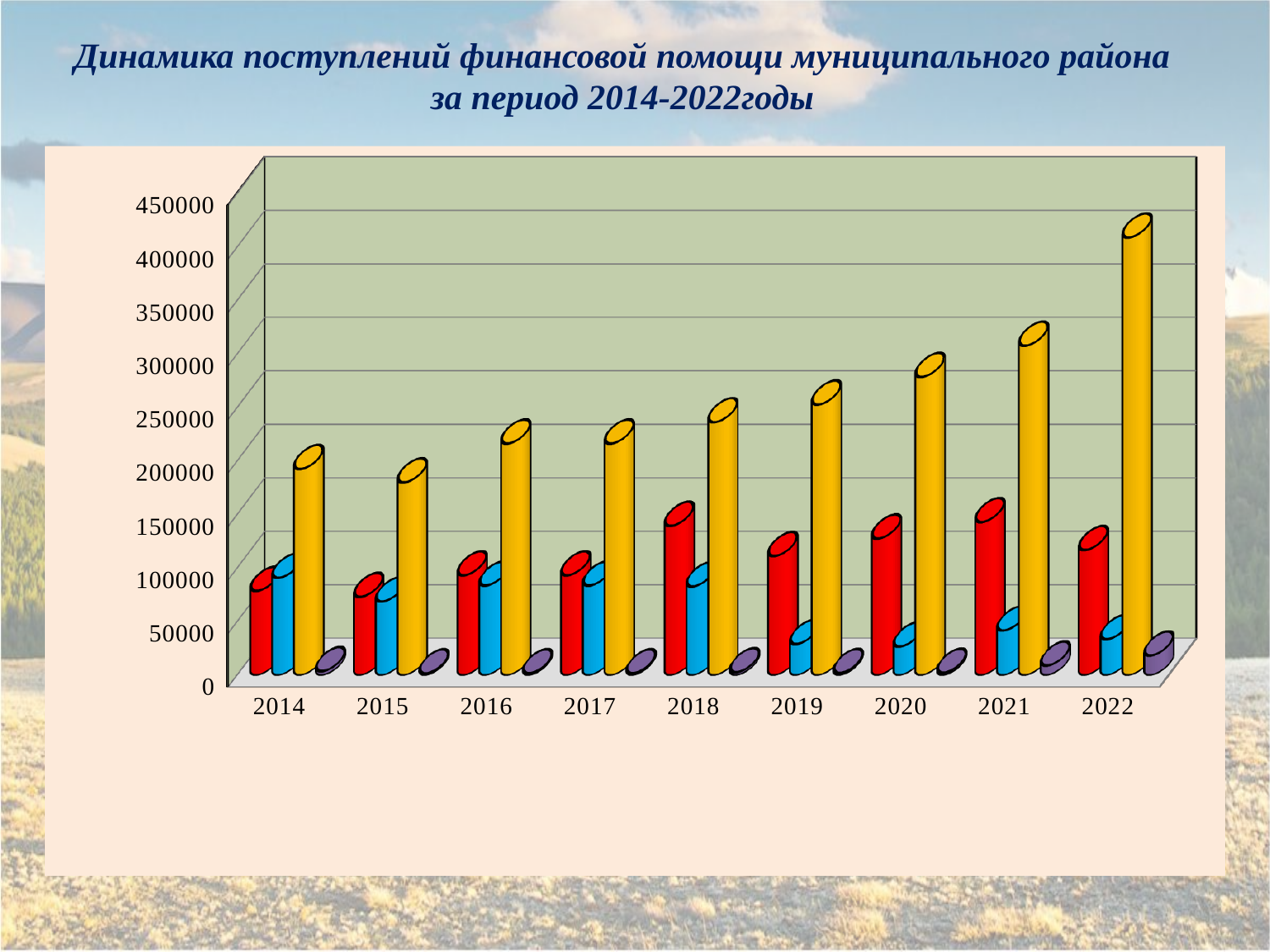
What is the title of the chart on the slide? Динамика поступлений финансовой помощи муниципального района за период 2014-2022годы Is the value of the yellow bar for 2022 greater or less than 400000? greater What kind of chart is shown on the slide? bar chart Is the value of the purple bar for 2018 greater or less than 50000? less In which year is the yellow bar the tallest? 2022 How many bars are plotted for each year in the chart? 4 Is the value of the blue bar for 2019 greater or less than 50000? less Which is larger, the yellow bar for 2022 or the yellow bar for 2014? 2022 Do the yellow bars generally rise or fall from 2014 to 2022? rise How many years are shown along the x axis of the chart? 9